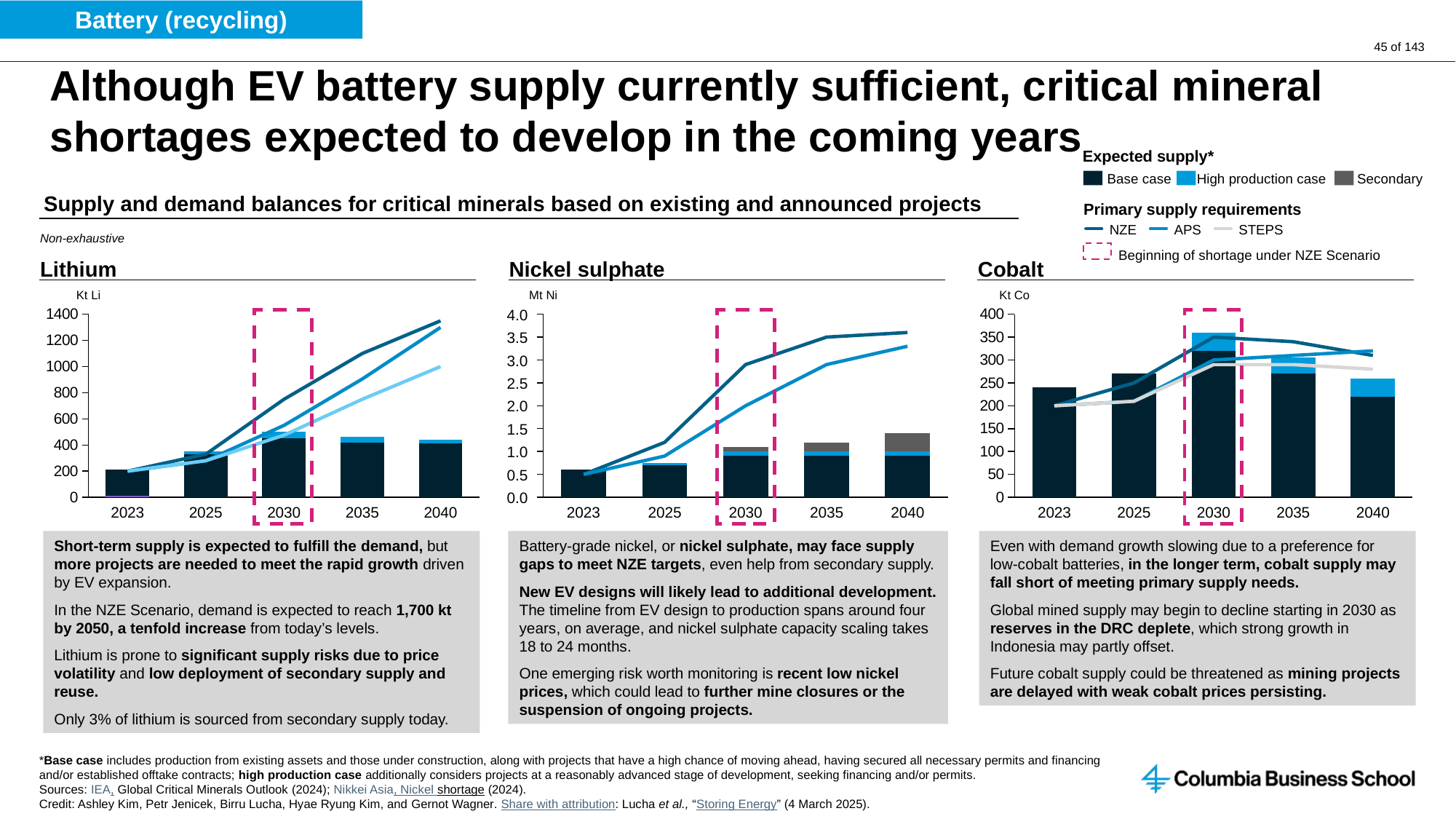
On the Lithium chart, how many years are shown on the x axis? 5 On the Lithium chart, in which year is the base case supply bar lowest? 2023 On the Nickel sulphate chart, is the NZE primary supply requirement in 2040 greater or less than 3.0? greater On the Cobalt chart, is the total stacked supply bar for 2030 greater or less than 300? greater On the Lithium chart, is the base case supply bar for 2023 greater or less than 400? less On the Cobalt chart, which is larger: the base case supply bar for 2030 or for 2040? 2030 On the Nickel sulphate chart, does the NZE primary supply requirement line rise or fall from 2023 to 2040? rise What kind of chart is the Cobalt chart? Bar chart with line series On the Cobalt chart, in which year is the base case supply bar highest? 2030 How many expected supply series does the legend list? 3